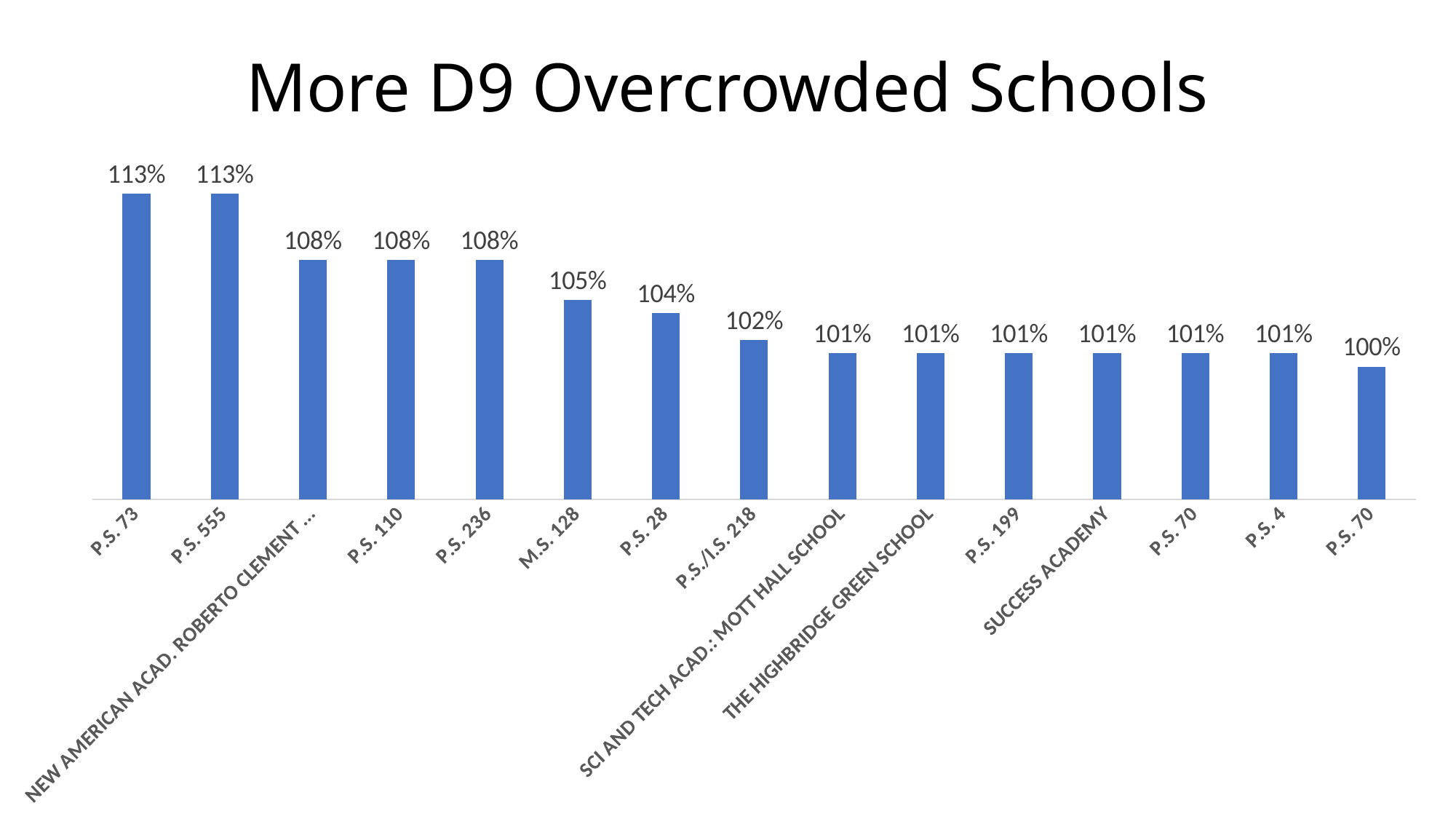
What is the value for P.S. 73? 113% What is the value for SUCCESS ACADEMY? 101% What is the title of the chart? More D9 Overcrowded Schools What is the value for P.S. 236? 108% What is the difference between the value for P.S. 73 and the value for M.S. 128? 8 percentage points What is the lowest value shown in the chart? 100% How many bars are shown in the chart? 15 What kind of chart is shown on the slide? bar chart What is the value for P.S./I.S. 218? 102% Which is larger, the value for P.S. 110 or the value for P.S. 28? P.S. 110 What is the value for P.S. 28? 104% What is the value for M.S. 128? 105%